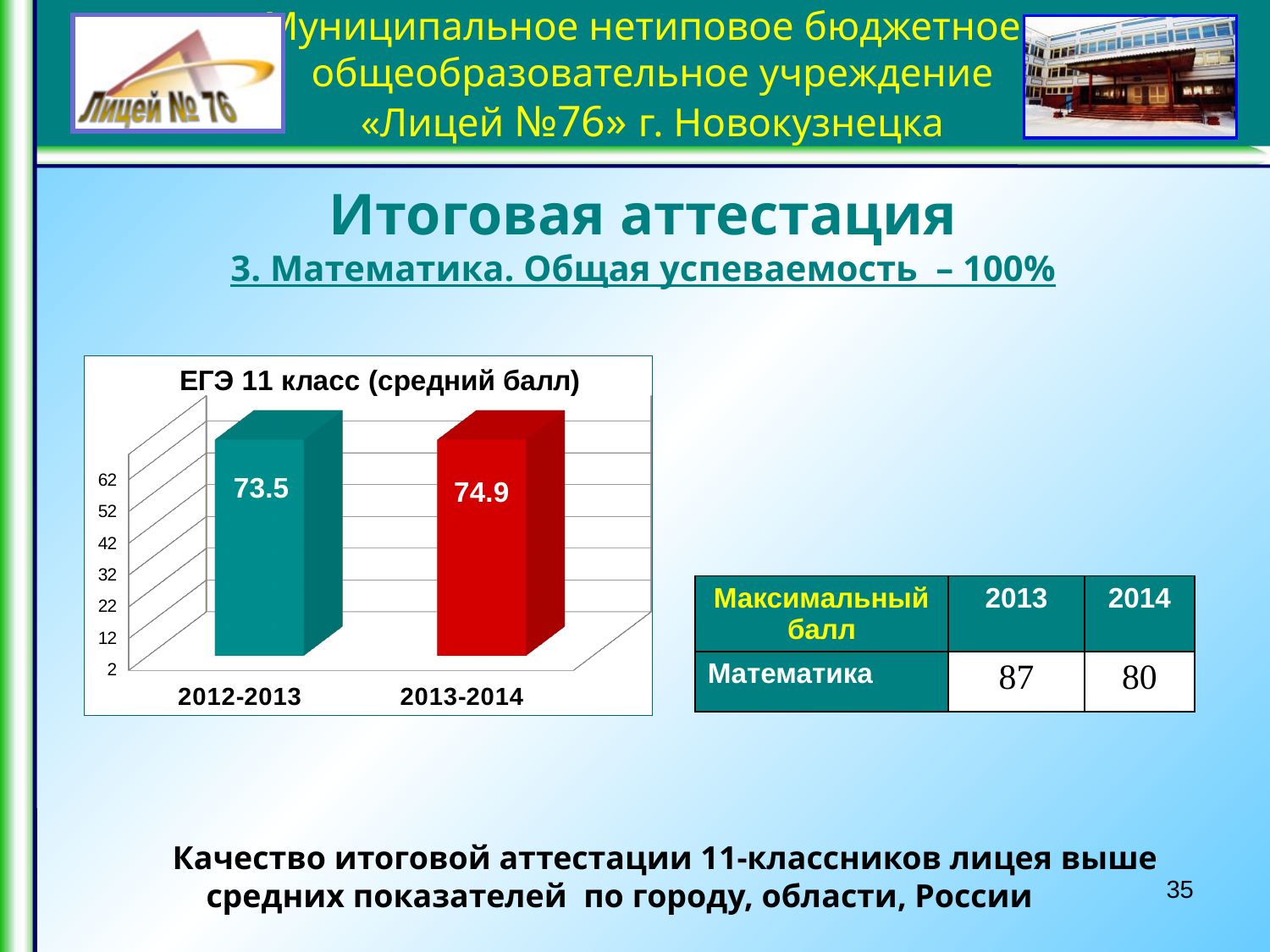
Which year has the lower average score in the chart? 2012-2013 What is the average score shown for 2013-2014 in the chart? 74.9 Is the value for 2013-2014 greater or less than 62? greater What kind of chart is shown on the slide? bar chart What is the title of the chart? ЕГЭ 11 класс (средний балл) What colour is the bar for 2013-2014? red Which year has the higher average score in the chart? 2013-2014 Is the value for 2012-2013 larger or smaller than the value for 2013-2014? smaller What is the difference between the 2013-2014 and 2012-2013 average scores? 1.4 What is the average score shown for 2012-2013 in the chart? 73.5 How many categories (years) are plotted in the chart? 2 Do the values rise or fall from 2012-2013 to 2013-2014? rise